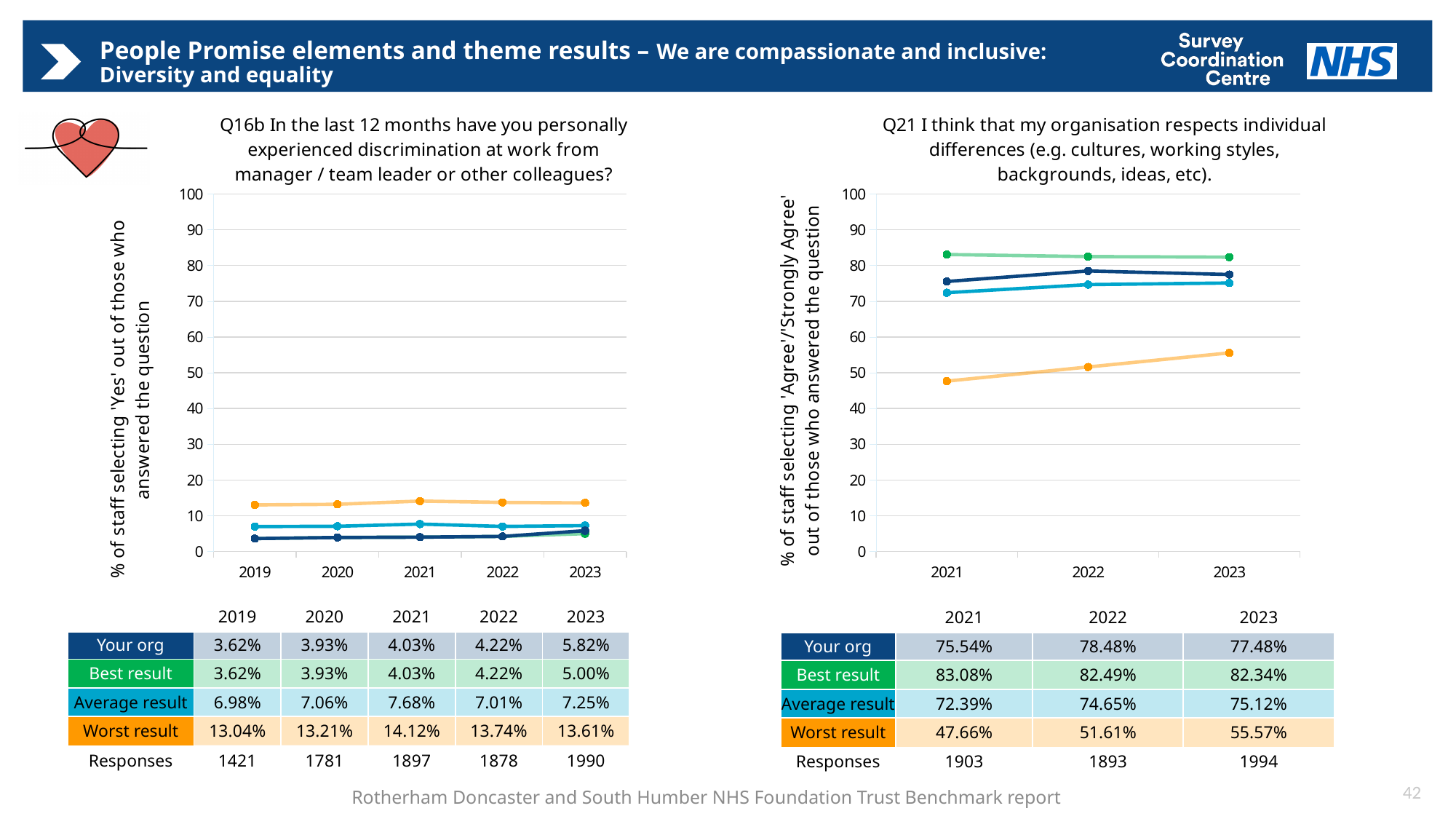
In the Q16b chart, what is the 'Your org' value for 2023? 5.82% In the Q16b chart, which year has the highest 'Worst result' value? 2021 In the Q21 chart, does the 'Worst result' line rise or fall from 2021 to 2023? Rise In the Q16b chart, which is larger in 2023: the 'Your org' value or the 'Best result' value? Your org In the Q21 chart, which year has the lowest 'Worst result' value? 2021 In the Q16b chart, what is the 'Average result' value for 2021? 7.68% How many years are plotted on the x axis of the Q16b chart? 5 How many result series (lines) are plotted in the Q21 chart? 4 What kind of chart is used for Q21? Line chart In the Q21 chart, by how many percentage points did the 'Your org' value change from 2021 to 2022? 2.94 percentage points In the Q21 chart, what is the 'Best result' value for 2021? 83.08% In the Q21 chart, is the 'Worst result' value for 2023 greater or less than 60? less